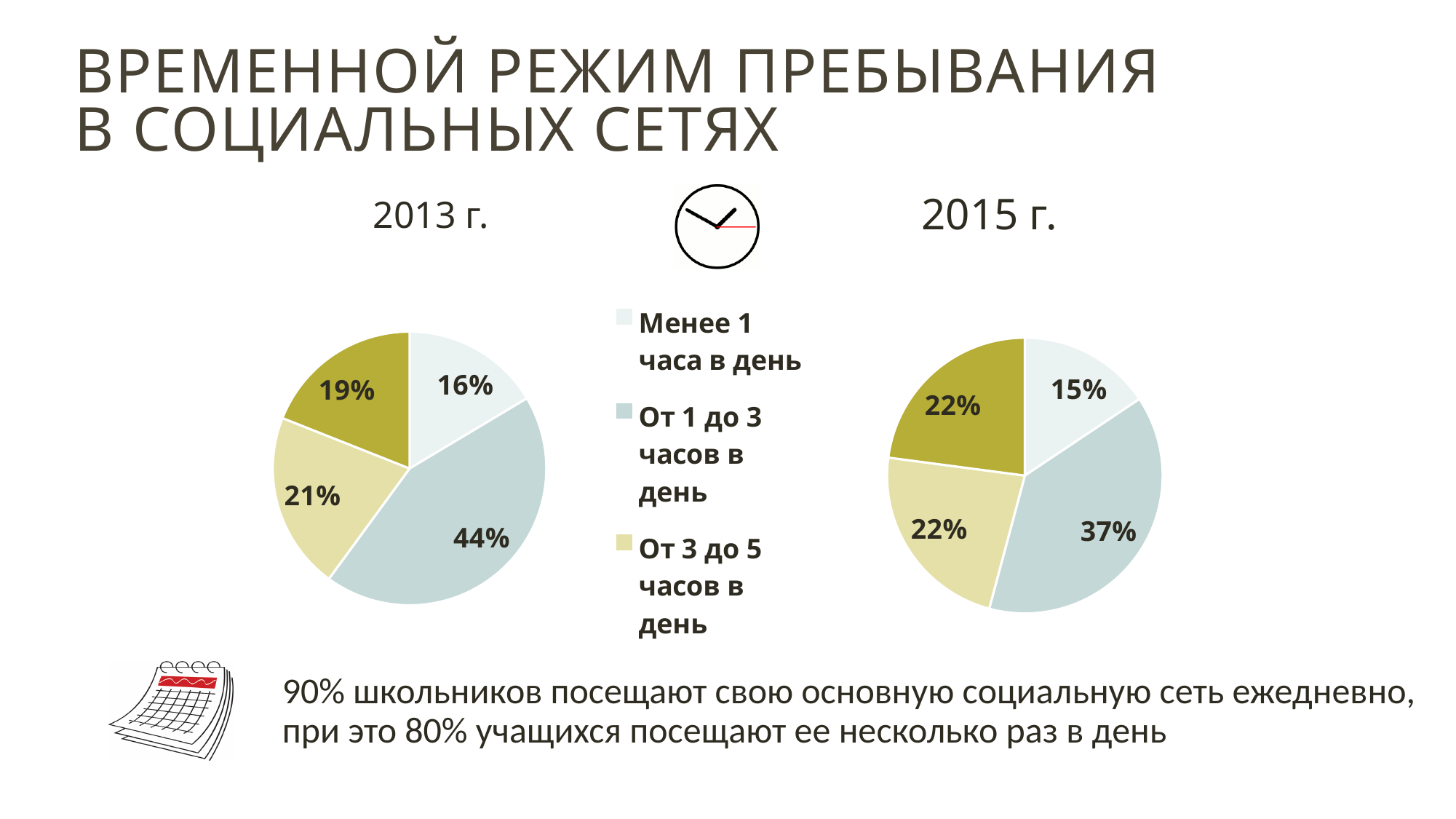
In the 2013 pie chart, what percentage is shown for "Менее 1 часа в день"? 16% By how many percentage points did the share for "От 1 до 3 часов в день" change from the 2013 chart to the 2015 chart? 7 percentage points How many slices does the 2013 pie chart have? 4 Which chart shows a larger share for "От 3 до 5 часов в день", the 2013 chart or the 2015 chart? 2015 What is the title of the slide containing the two pie charts? ВРЕМЕННОЙ РЕЖИМ ПРЕБЫВАНИЯ В СОЦИАЛЬНЫХ СЕТЯХ How many entries does the legend between the two charts list? 3 In the 2013 pie chart, which category has the largest slice? От 1 до 3 часов в день In the 2013 pie chart, what percentage is shown for "От 1 до 3 часов в день"? 44% In the 2015 pie chart, which category has the smallest slice? Менее 1 часа в день What type of chart is used for the 2013 and 2015 data? Pie chart In the 2015 pie chart, what percentage is shown for "Менее 1 часа в день"? 15% In the 2015 pie chart, what percentage is shown for "От 3 до 5 часов в день"? 22%